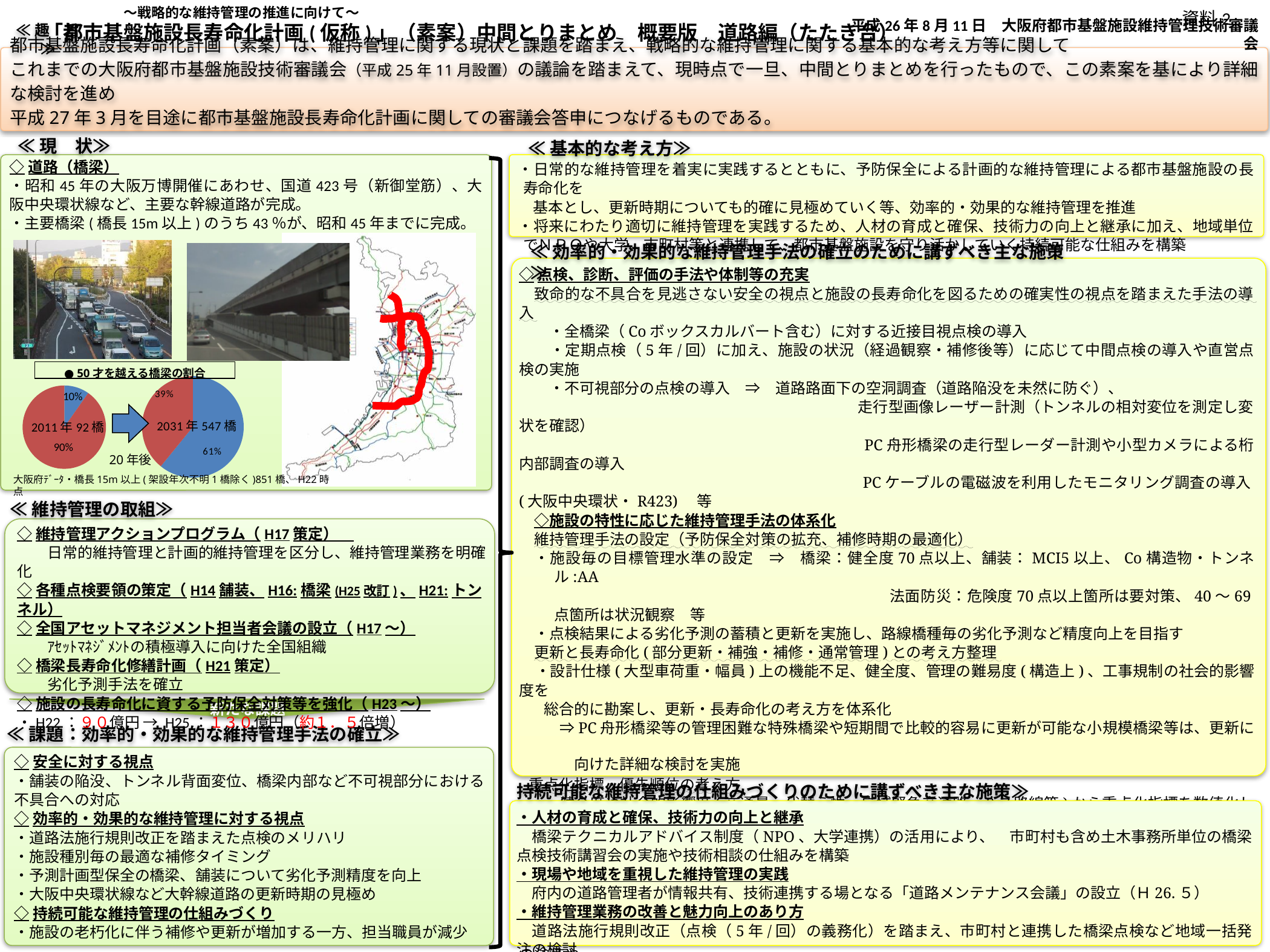
By how many percentage points does the blue slice in the right pie chart (2031年, 61%) exceed the blue slice in the left pie chart (2011年, 10%)? 51 percentage points What is the title printed above the two pie charts? ●50才を越える橋梁の割合 How many pie charts are shown under the heading ●50才を越える橋梁の割合? 2 In the left pie chart (2011年), what percentage is shown for the blue slice? 10% In the right pie chart (2031年), what percentage is shown for the red slice? 39% What number of bridges is labelled on the left pie chart for 2011年? 92橋 In the right pie chart (2031年), which slice is larger, the blue one or the red one? blue In the right pie chart (2031年), what percentage is shown for the blue slice? 61% In the left pie chart (2011年), what percentage is shown for the red slice? 90% In the left pie chart (2011年), which slice is larger, the blue one or the red one? red What number of bridges is labelled on the right pie chart for 2031年? 547橋 What kind of charts are shown under the heading ●50才を越える橋梁の割合? pie charts